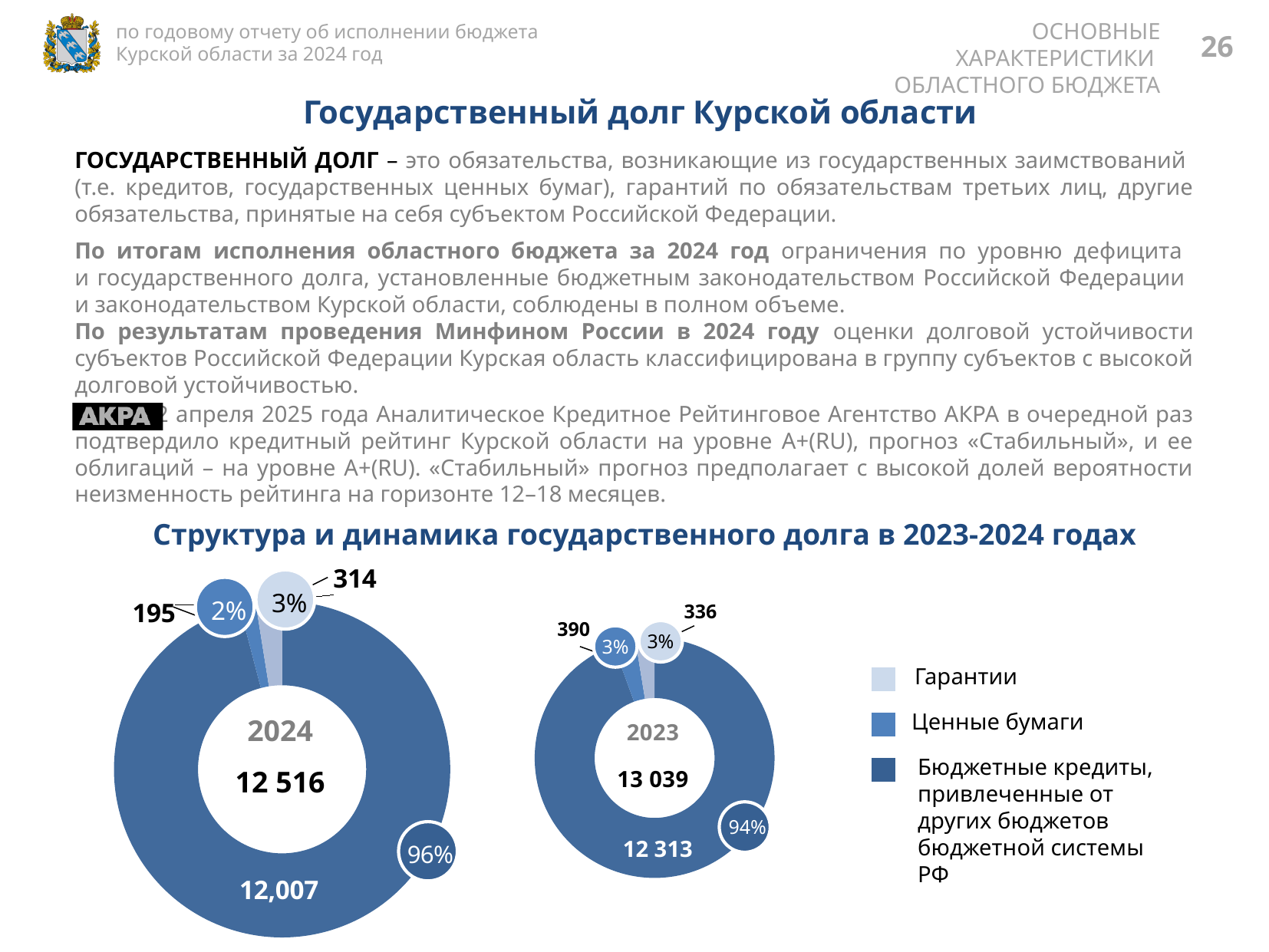
In the 2023 donut chart, what is the value for Ценные бумаги? 390 What is the total state debt shown in the centre of the 2024 donut chart? 12 516 What is the difference between Ценные бумаги in 2023 and Ценные бумаги in 2024? 195 In the 2024 donut chart, what is the value for Бюджетные кредиты? 12,007 What is the total state debt shown in the centre of the 2023 donut chart? 13 039 In the 2023 donut chart, which category has the largest value? Бюджетные кредиты, привлеченные от других бюджетов бюджетной системы РФ Which is larger: Гарантии in 2024 or Гарантии in 2023? Гарантии in 2023 In the 2023 donut chart, what share of the total do Бюджетные кредиты make up? 94% How many categories does the legend list for the donut charts? 3 In the 2024 donut chart, which category has the smallest value? Ценные бумаги In the 2024 donut chart, what share of the total do Ценные бумаги make up? 2% In the 2024 donut chart, what is the value for Гарантии? 314